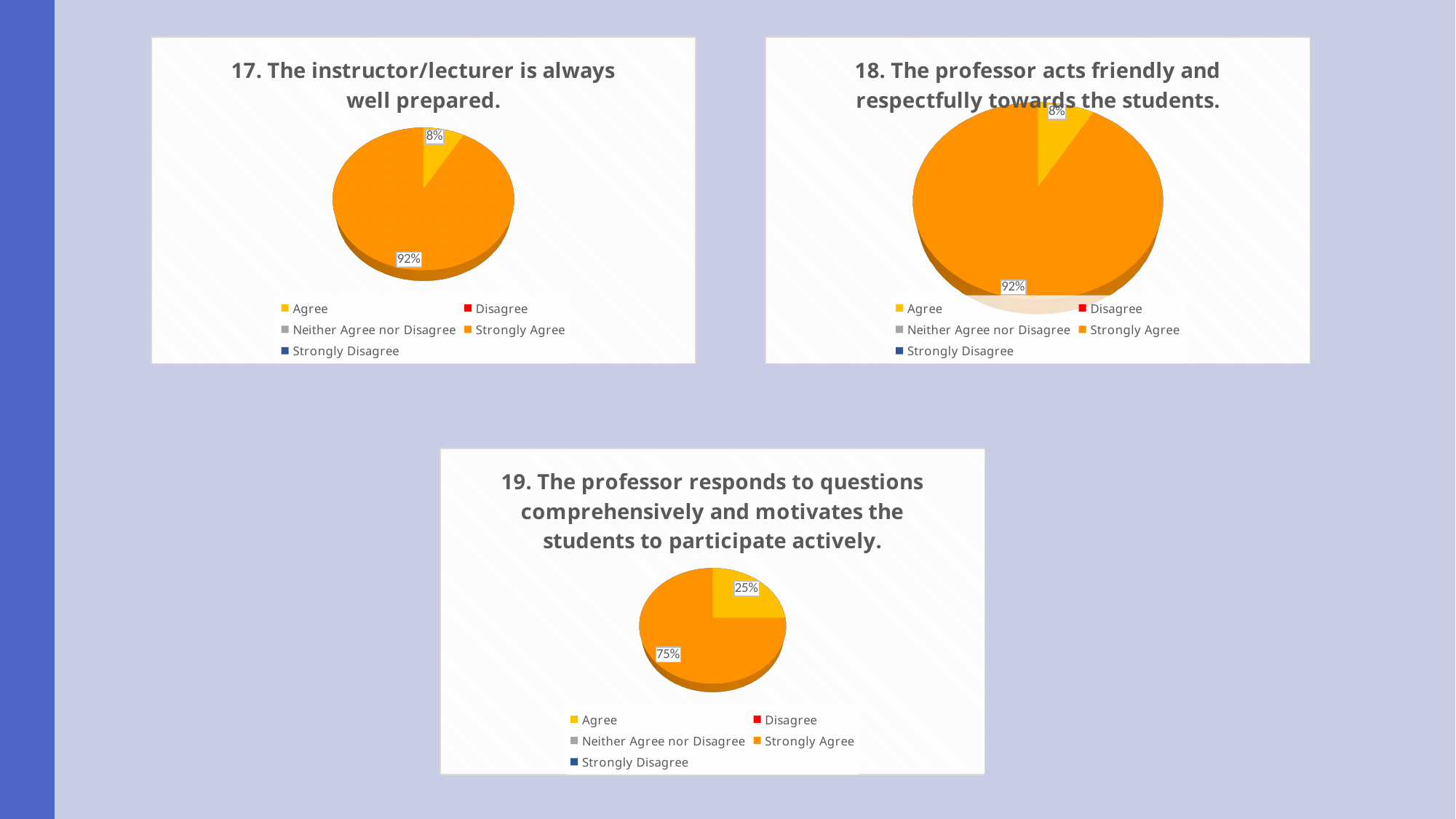
In the chart titled "19. The professor responds to questions comprehensively and motivates the students to participate actively.", what share of the pie is Agree? 25% In the chart titled "17. The instructor/lecturer is always well prepared.", what share of the pie is Agree? 8% How many entries does the legend list in the chart titled "17. The instructor/lecturer is always well prepared."? 5 In the chart titled "19. The professor responds to questions comprehensively and motivates the students to participate actively.", what share of the pie is Strongly Agree? 75% What kind of chart is the chart titled "18. The professor acts friendly and respectfully towards the students."? Pie chart In the chart titled "19. The professor responds to questions comprehensively and motivates the students to participate actively.", which response has the largest slice? Strongly Agree In the chart titled "17. The instructor/lecturer is always well prepared.", which is larger, Agree or Strongly Agree? Strongly Agree In the chart titled "19. The professor responds to questions comprehensively and motivates the students to participate actively.", what colour is the Agree slice? Yellow In the chart titled "19. The professor responds to questions comprehensively and motivates the students to participate actively.", what is the difference between the Strongly Agree and Agree shares? 50%